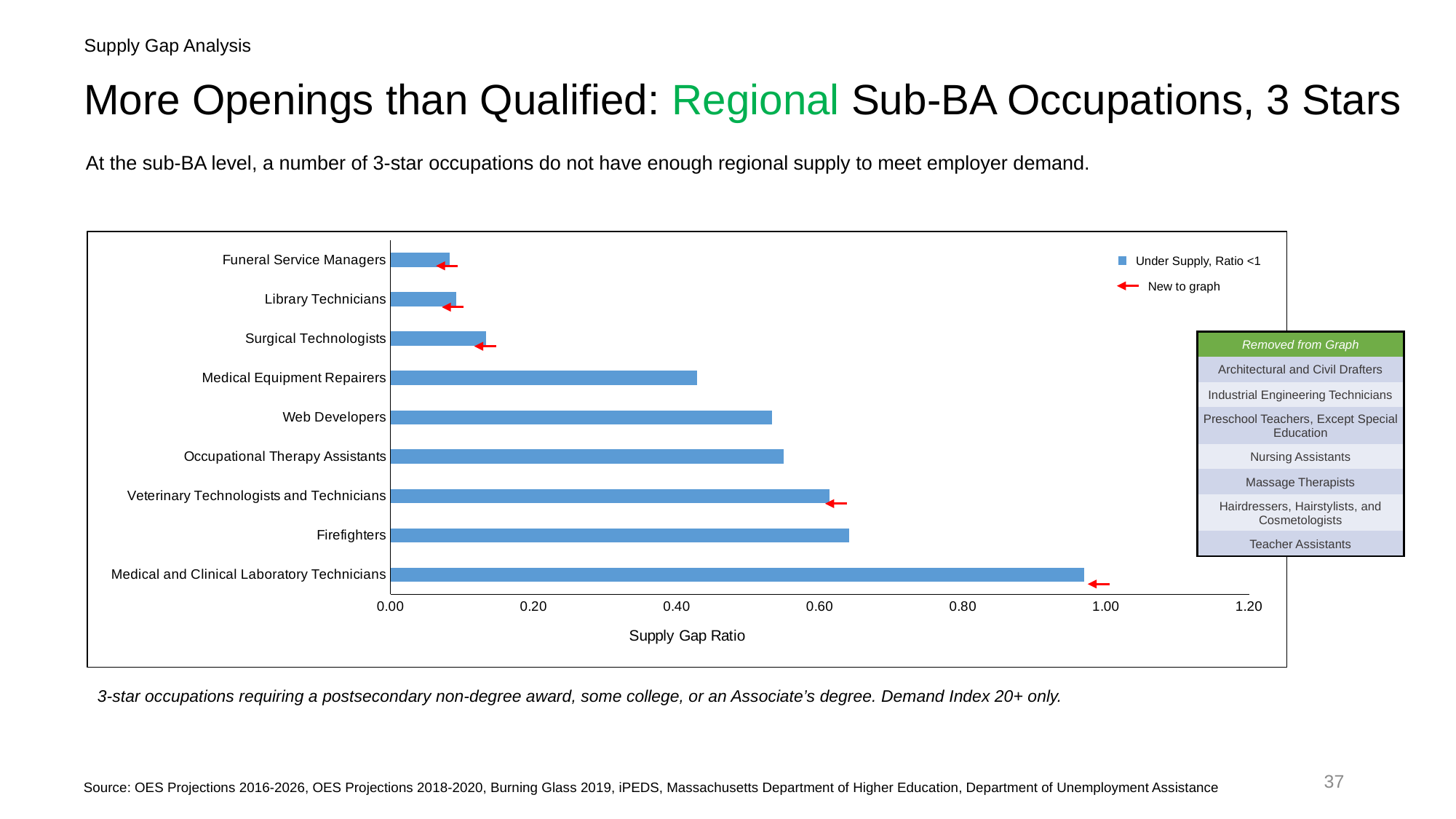
What is the title of the horizontal axis of the chart? Supply Gap Ratio Which occupation has the highest Supply Gap Ratio in the chart? Medical and Clinical Laboratory Technicians Is the Supply Gap Ratio for Medical and Clinical Laboratory Technicians greater or less than 0.80? greater Is the Supply Gap Ratio for Surgical Technologists greater or less than 0.20? less Is the Supply Gap Ratio for Web Developers greater or less than 0.40? greater How many occupations are plotted in the chart? 9 How many occupations in the chart are marked with a red arrow as "New to graph"? 5 Which has a larger Supply Gap Ratio, Medical Equipment Repairers or Web Developers? Web Developers Which has a larger Supply Gap Ratio, Surgical Technologists or Occupational Therapy Assistants? Occupational Therapy Assistants What kind of chart is shown on the slide? bar chart